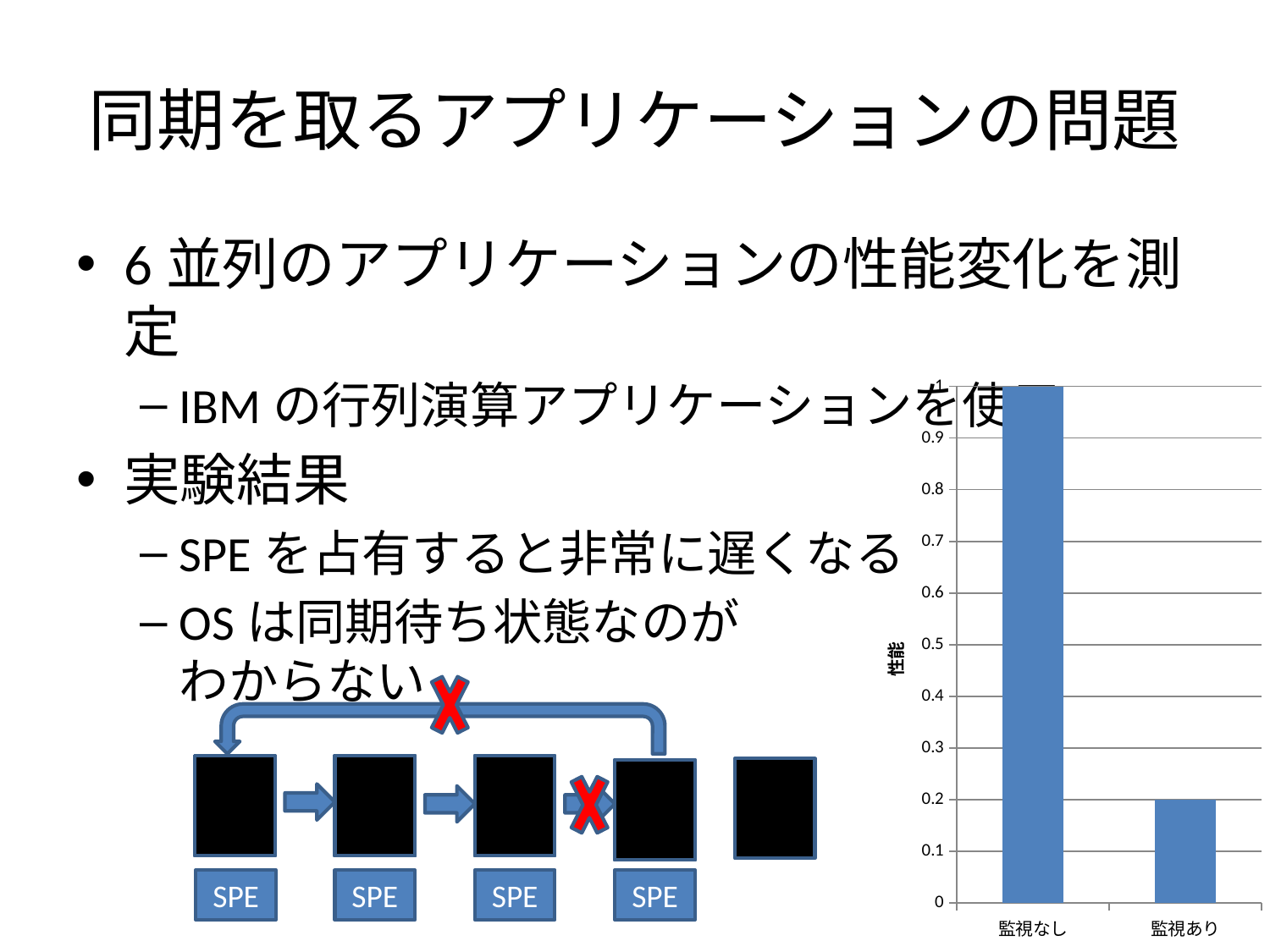
What is the value for 監視あり in the bar chart? 0.2 What is the label of the y axis of the bar chart? 性能 How many categories are shown on the x axis of the bar chart? 2 Do the values rise or fall from 監視なし to 監視あり along the x axis? fall Which category has the highest value in the bar chart? 監視なし What is the value for 監視なし in the bar chart? 1 Is the value for 監視なし greater or less than 0.5? greater What kind of chart is shown on the right side of the slide? bar chart Is the value for 監視あり greater or less than 0.5? less Which category has the lowest value in the bar chart? 監視あり What is the difference between the values for 監視なし and 監視あり? 0.8 Which is larger, the value for 監視なし or the value for 監視あり? 監視なし